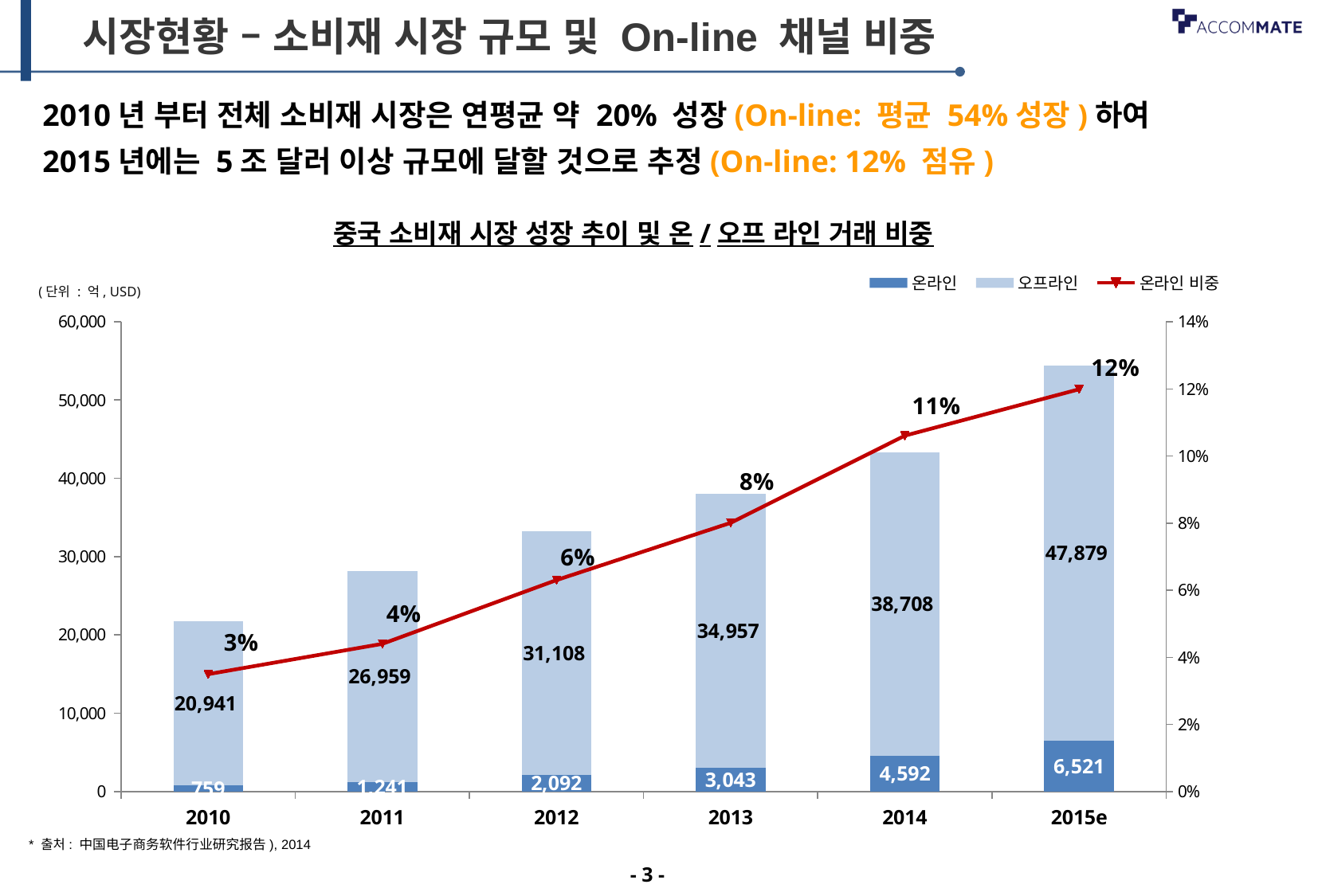
What is the total of the stacked bar for 2015e (online plus offline)? 54,400 Does the online share (온라인 비중) line rise or fall from 2010 to 2015e? rise What is the online (온라인) value for 2012? 2,092 How many series does the legend list? 3 What is the offline (오프라인) value for 2013? 34,957 Which is larger, the online value for 2013 or the online value for 2014? 2014 How many years are shown on the x axis? 6 Which year has the highest offline (오프라인) value? 2015e What online share (온라인 비중) is shown for 2014? 11% What is the difference between the offline values for 2015e and 2014? 9,171 Which year has the lowest online share (온라인 비중)? 2010 What is the online (온라인) value for 2015e? 6,521